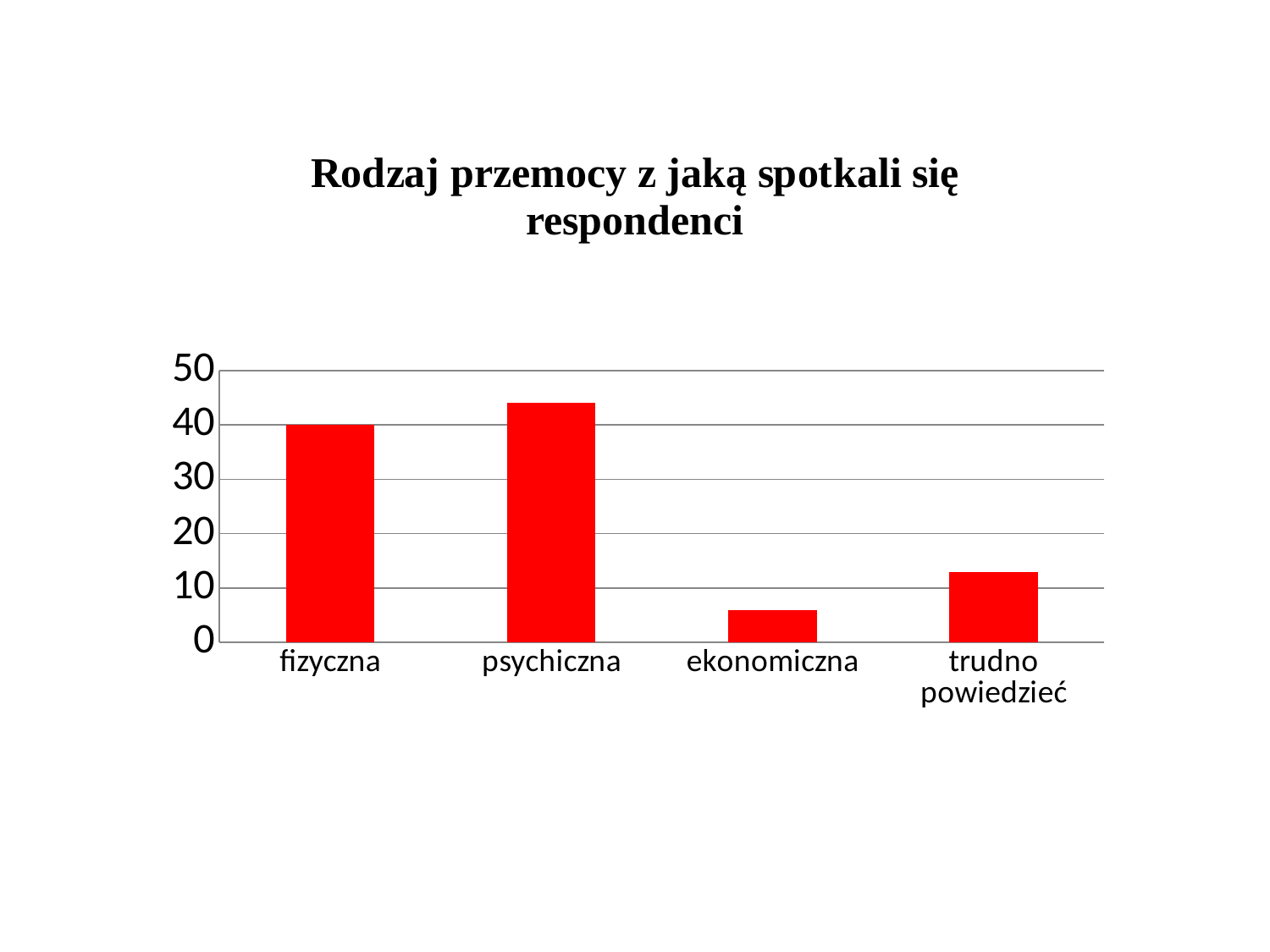
How many categories are shown on the x axis of the chart? 4 Which is larger, the value for ekonomiczna or the value for trudno powiedzieć? trudno powiedzieć What is the value for fizyczna? 40 What type of chart is shown on the slide? bar chart What is the title of the chart? Rodzaj przemocy z jaką spotkali się respondenci Which category has the highest value? psychiczna Which category has the lowest value? ekonomiczna What colour are the bars in the chart? red Is the value for ekonomiczna greater or less than 10? less Which is larger, the value for fizyczna or the value for trudno powiedzieć? fizyczna Is the value for trudno powiedzieć greater or less than 10? greater Is the value for psychiczna greater or less than 40? greater